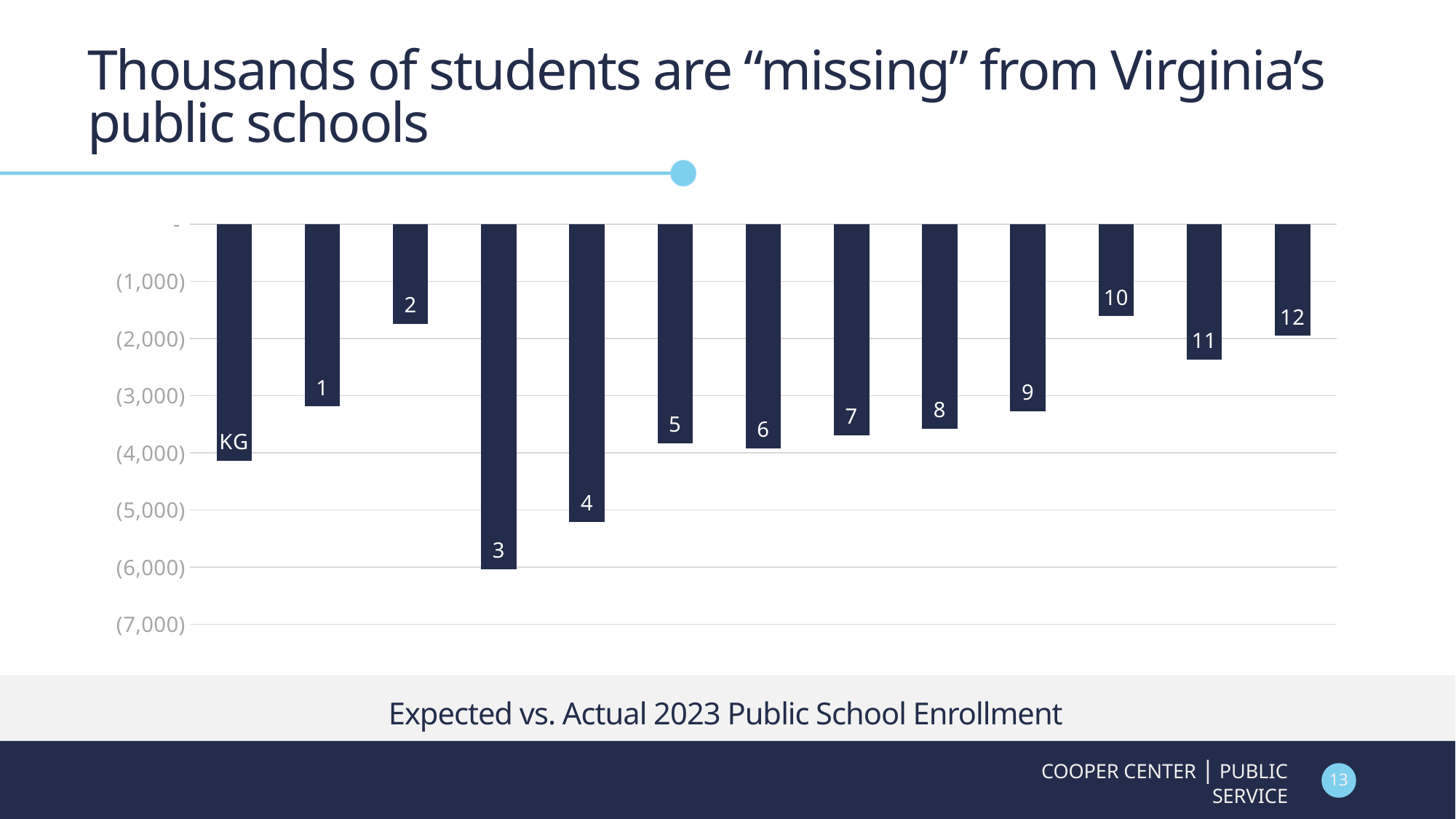
What is the caption shown below the chart? Expected vs. Actual 2023 Public School Enrollment Which has the lower (more negative) value, KG or grade 1? KG How many grade categories are plotted in the chart? 13 Is the value for grade 10 greater or less than (2,000)? greater Is the value for grade 4 greater or less than (4,000)? less What kind of chart is shown on the slide? Bar chart Is the value for grade 11 greater or less than (2,000)? less Which has the lower (more negative) value, grade 3 or grade 4? 3 Which grade has the lowest (most negative) value in the chart? 3